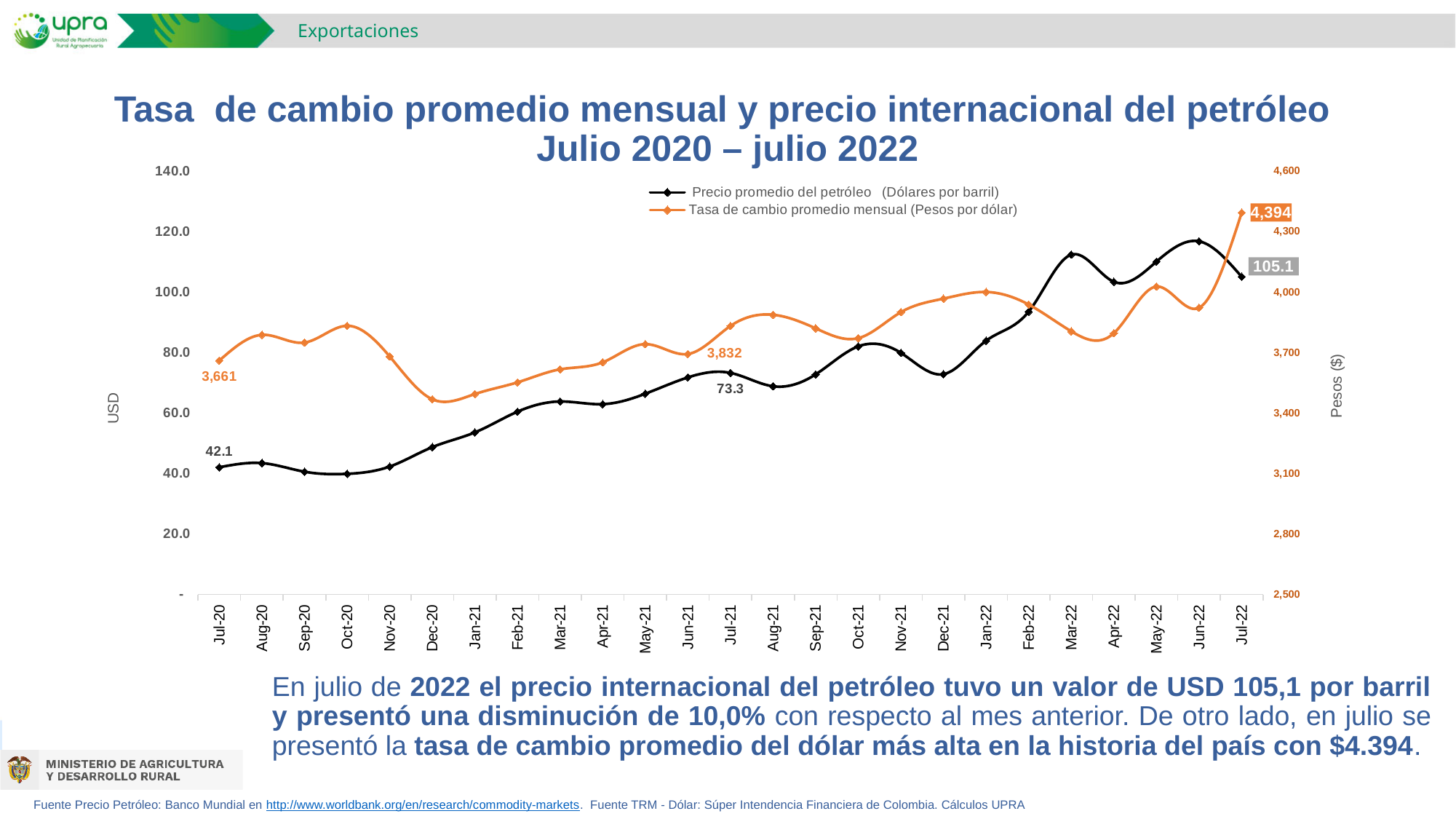
Which is larger, the oil price in Jul-22 or in Jul-21? Jul-22 What kind of chart is shown on the slide? Line chart What was the average monthly exchange rate (Pesos por dólar) in Jul-22? 4,394 Is the exchange rate in Dec-20 greater or less than 3,700? less By how much did the exchange rate in Jul-22 exceed the exchange rate in Jul-20? 733 What was the average monthly exchange rate in Jul-21? 3,832 What is the difference between the oil price in Jul-22 and in Jul-20? 63.0 In which month did the Tasa de cambio promedio mensual reach its highest value? Jul-22 How many series does the legend list? 2 What was the average oil price in Jul-21? 73.3 Is the oil price in Mar-22 greater or less than 100.0? greater What was the average oil price (Dólares por barril) in Jul-20? 42.1